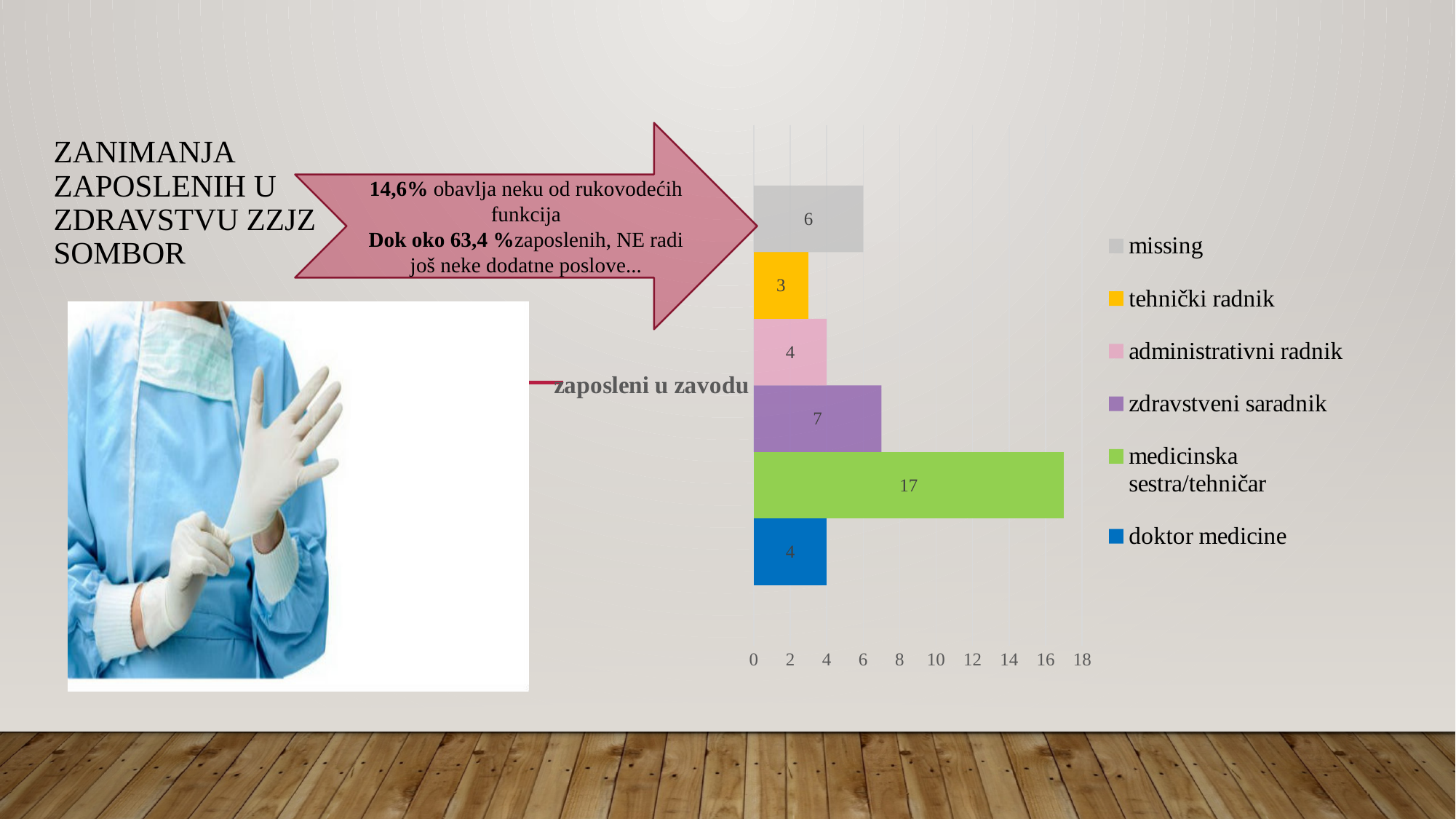
What is the value for zdravstveni saradnik? 7 How many series does the legend list? 6 What is the value for missing? 6 Which series has the lowest value? tehnički radnik Which series has the highest value? medicinska sestra/tehničar Which is larger, the value for missing or the value for doktor medicine? missing What is the category label shown on the vertical axis of the chart? zaposleni u zavodu Is the value for medicinska sestra/tehničar greater or less than 10? greater What is the difference between the values for medicinska sestra/tehničar and zdravstveni saradnik? 10 What is the value for tehnički radnik? 3 What is the value for medicinska sestra/tehničar? 17 What type of chart is shown on the slide? bar chart